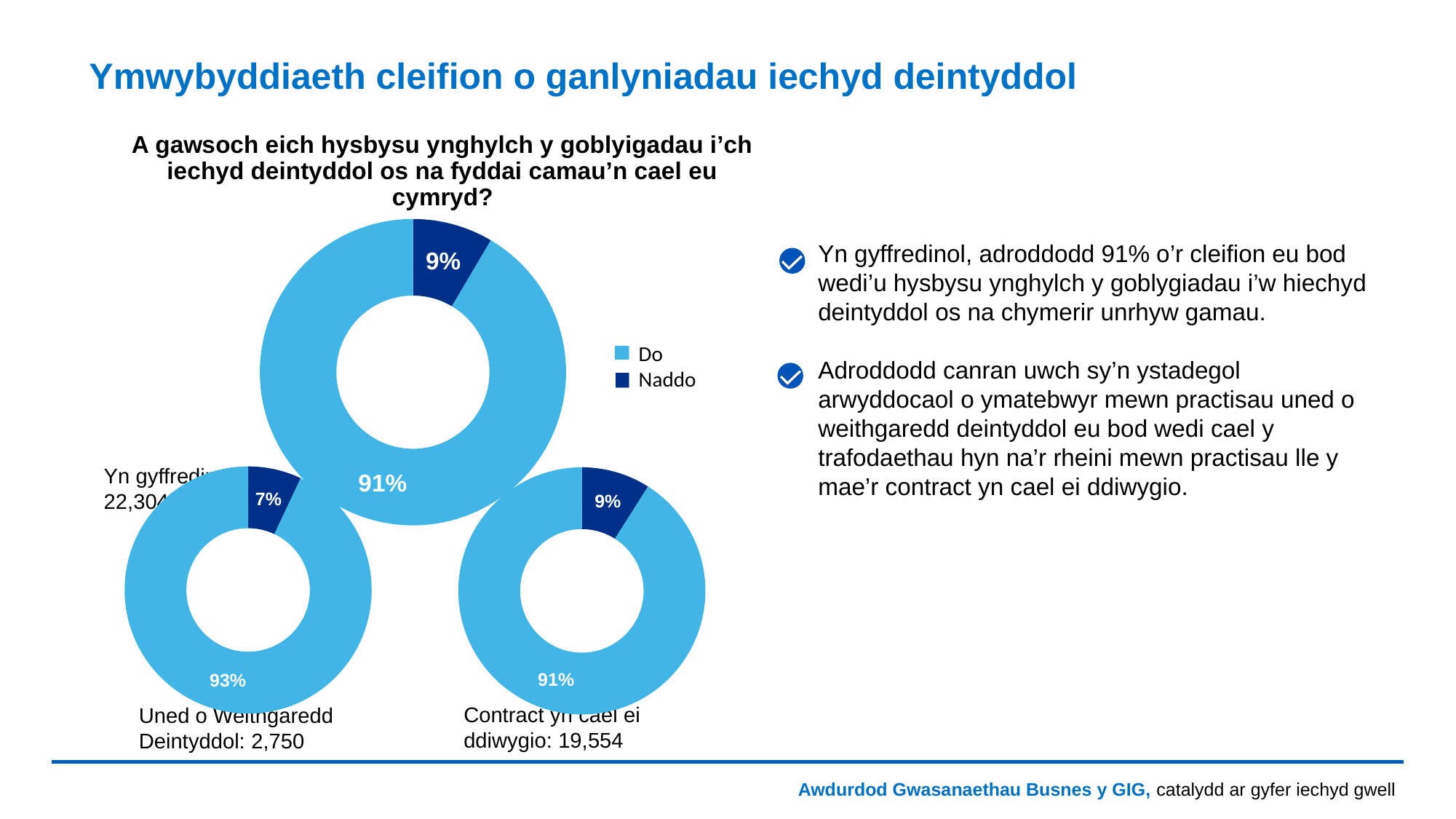
In the bottom-right donut chart (Contract yn cael ei ddiwygio), what share is labelled for Naddo? 9% What are the two legend entries? Do, Naddo In the large top-centre donut chart, what share is labelled for Do? 91% How many donut charts are shown on the slide? 3 How many series does the legend list? 2 In the bottom-right donut chart (Contract yn cael ei ddiwygio), what share is labelled for Do? 91% What kind of chart is used on this slide? Donut (pie) chart What is the difference between the Do share in the bottom-left donut chart and the Do share in the bottom-right donut chart? 2 percentage points Which donut chart has the larger Do share: the bottom-left (Uned o Weithgaredd Deintyddol) or the bottom-right (Contract yn cael ei ddiwygio)? Bottom-left (Uned o Weithgaredd Deintyddol)